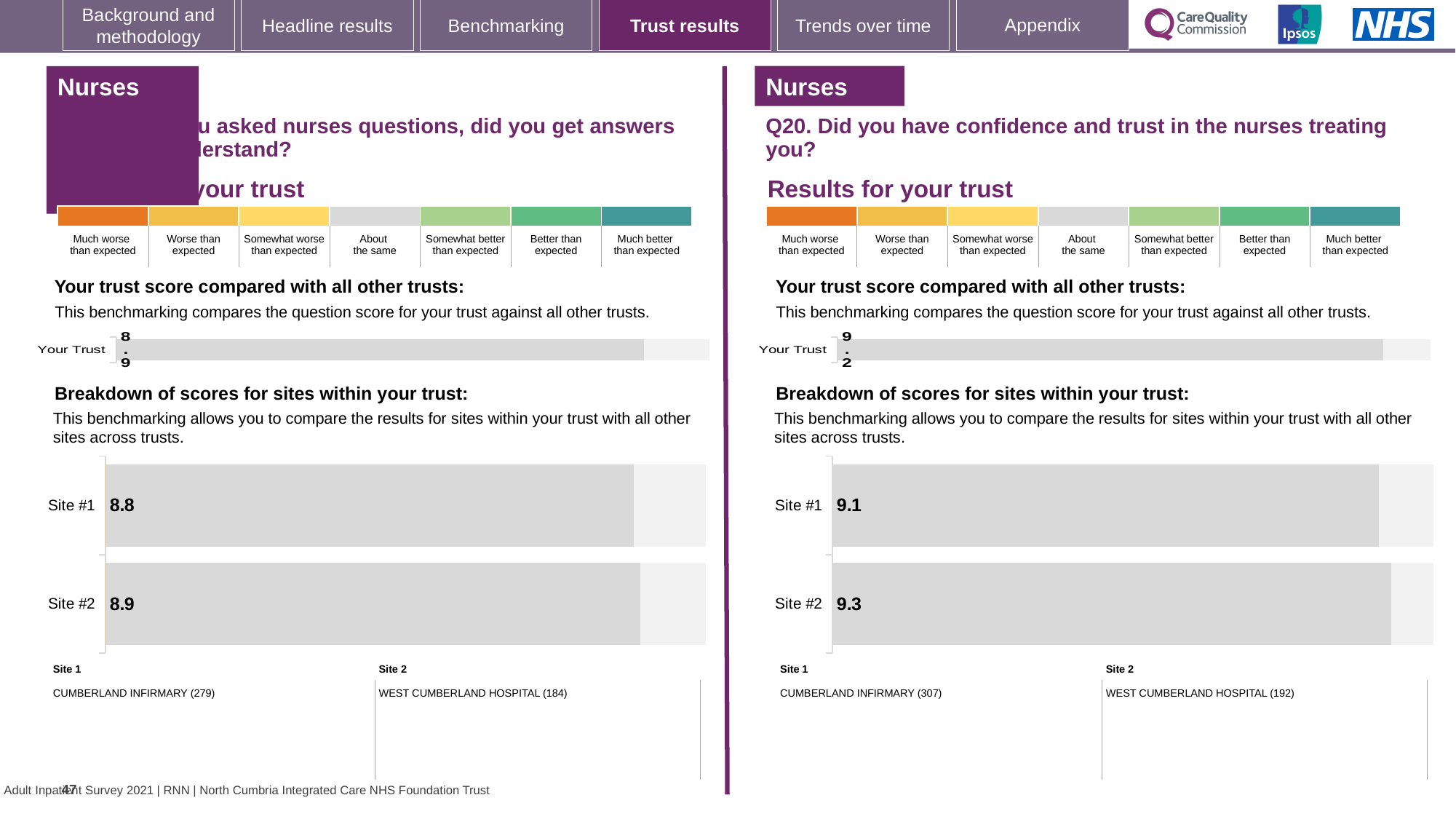
On the right-hand (Q20) 'Your trust score compared with all other trusts' chart, what is the score shown for Your Trust? 9.2 On the right-hand (Q20) site breakdown chart, what is the score for Site #2? 9.3 On the left-hand site breakdown chart, which site has the lower score? Site #1 On the left-hand site breakdown chart, what is the score for Site #1? 8.8 On the right-hand (Q20) site breakdown chart, what is the score for Site #1? 9.1 How many sites are shown on the right-hand (Q20) site breakdown chart? 2 On the left-hand site breakdown chart, what is the difference between the Site #2 and Site #1 scores? 0.1 On the left-hand 'Your trust score compared with all other trusts' chart, what is the score shown for Your Trust? 8.9 On the left-hand site breakdown chart, what is the score for Site #2? 8.9 What type of chart is the right-hand (Q20) site breakdown chart? Bar chart On the right-hand (Q20) site breakdown chart, what is the difference between the Site #2 and Site #1 scores? 0.2 On the right-hand (Q20) site breakdown chart, which site has the higher score? Site #2